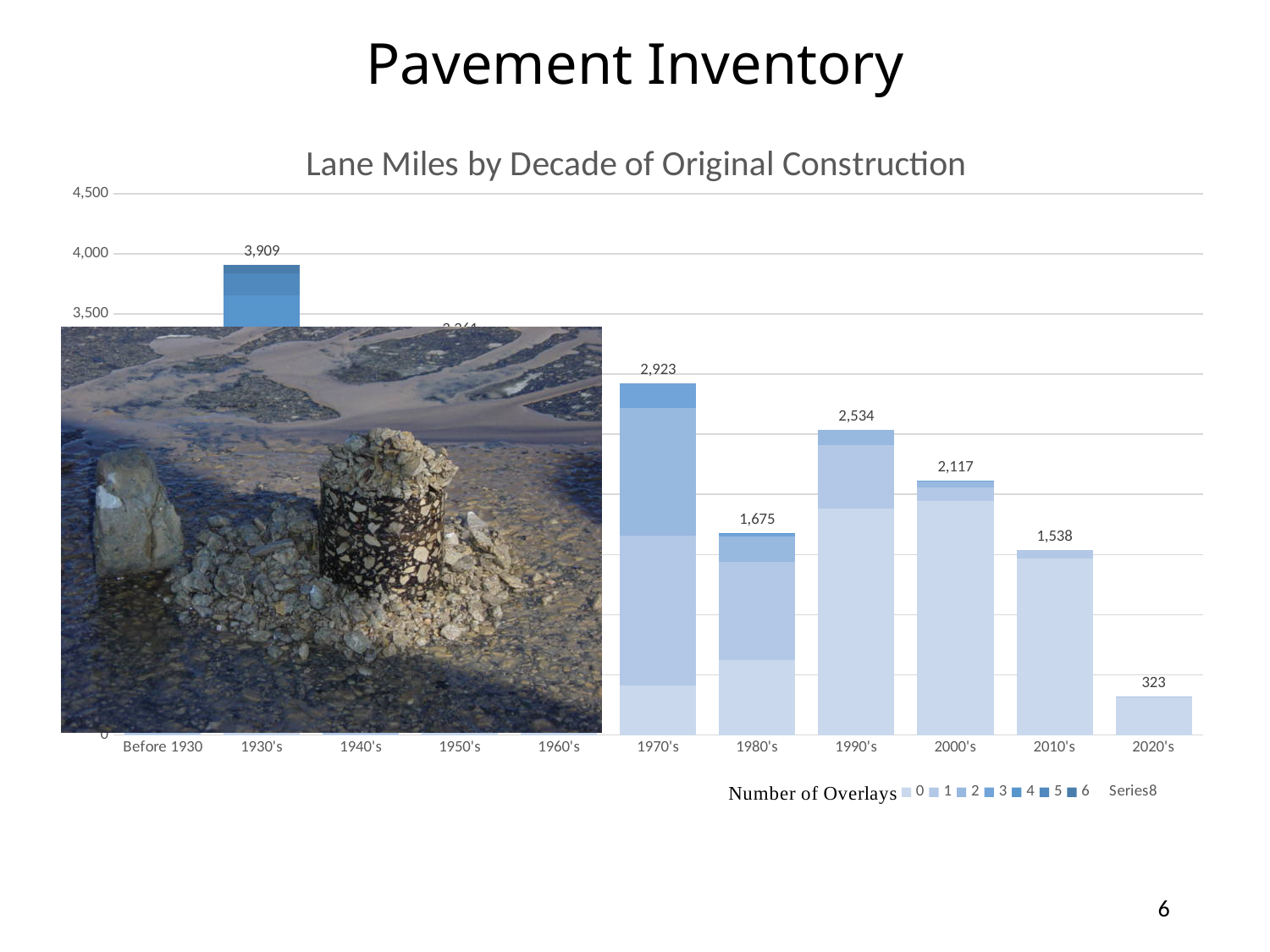
Which decade has the highest lane miles in the chart? 1930's What is the value for the 1970's in the chart? 2,923 Is the value for the 1930's greater or less than 3,500? greater What is the difference between the values for the 1990's and the 2000's? 417 What is the difference between the values for the 1970's and the 1980's? 1,248 Do the values rise or fall from the 1990's to the 2020's? Fall How many decade categories are shown on the x axis of the chart? 11 What is the value for the 1980's in the chart? 1,675 What is the value for the 2020's in the chart? 323 What is the value for the 1930's in the Lane Miles by Decade of Original Construction chart? 3,909 Which is larger, the value for the 1990's or the value for the 2010's? 1990's What kind of chart is shown on the slide? Stacked bar chart